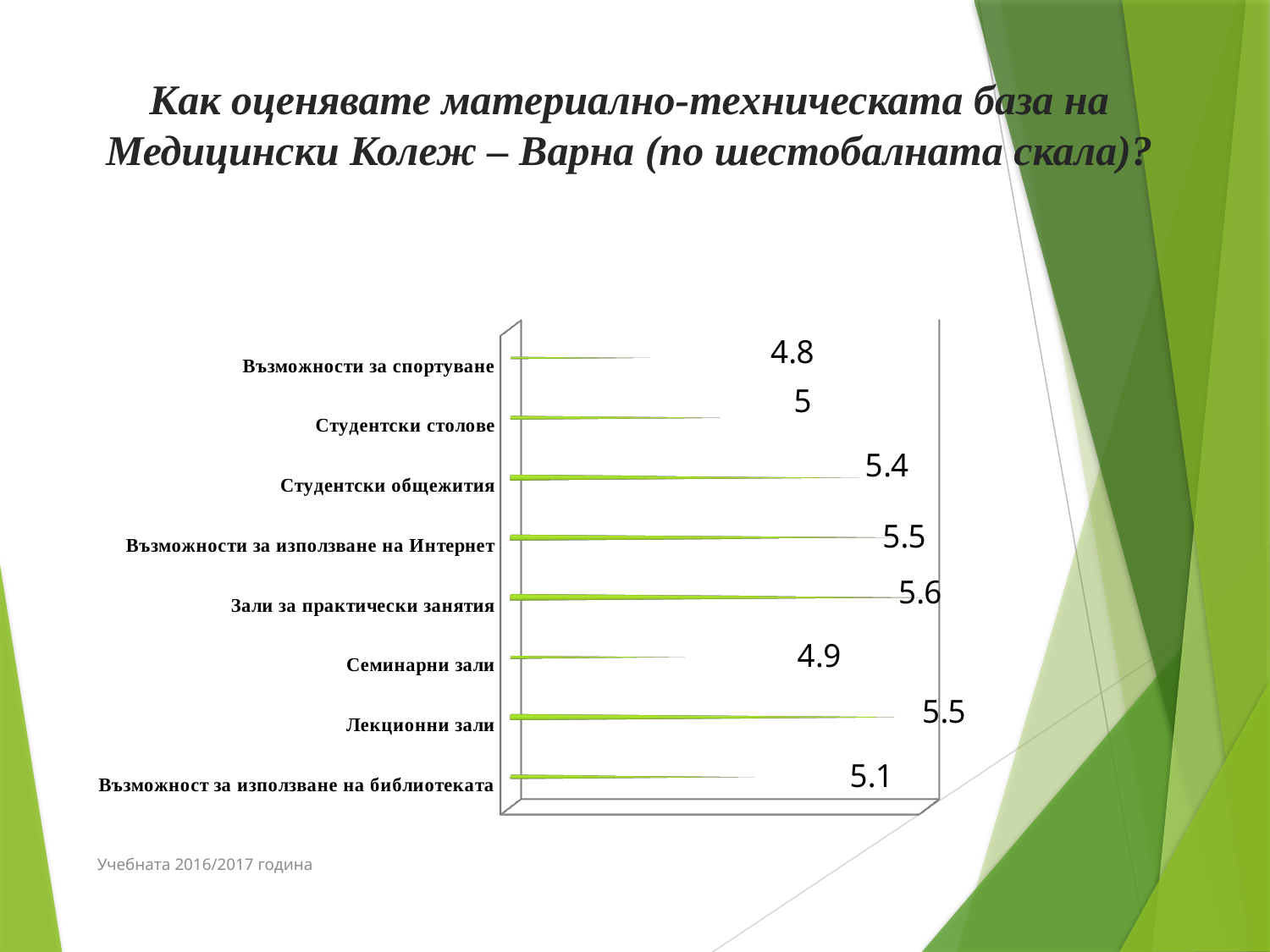
What is the value for Възможности за спортуване? 4.8 Which is larger, the value for Лекционни зали or the value for Студентски столове? Лекционни зали What is the value for Студентски общежития? 5.4 What is the difference between the values for Зали за практически занятия and Възможности за спортуване? 0.8 What is the value for Възможност за използване на библиотеката? 5.1 Which category has the lowest value? Възможности за спортуване What is the value for Семинарни зали? 4.9 What is the value for Студентски столове? 5 How many categories are shown in the chart? 8 Which category has the highest value? Зали за практически занятия What kind of chart is shown on the slide? Bar chart What is the difference between the values for Студентски общежития and Семинарни зали? 0.5